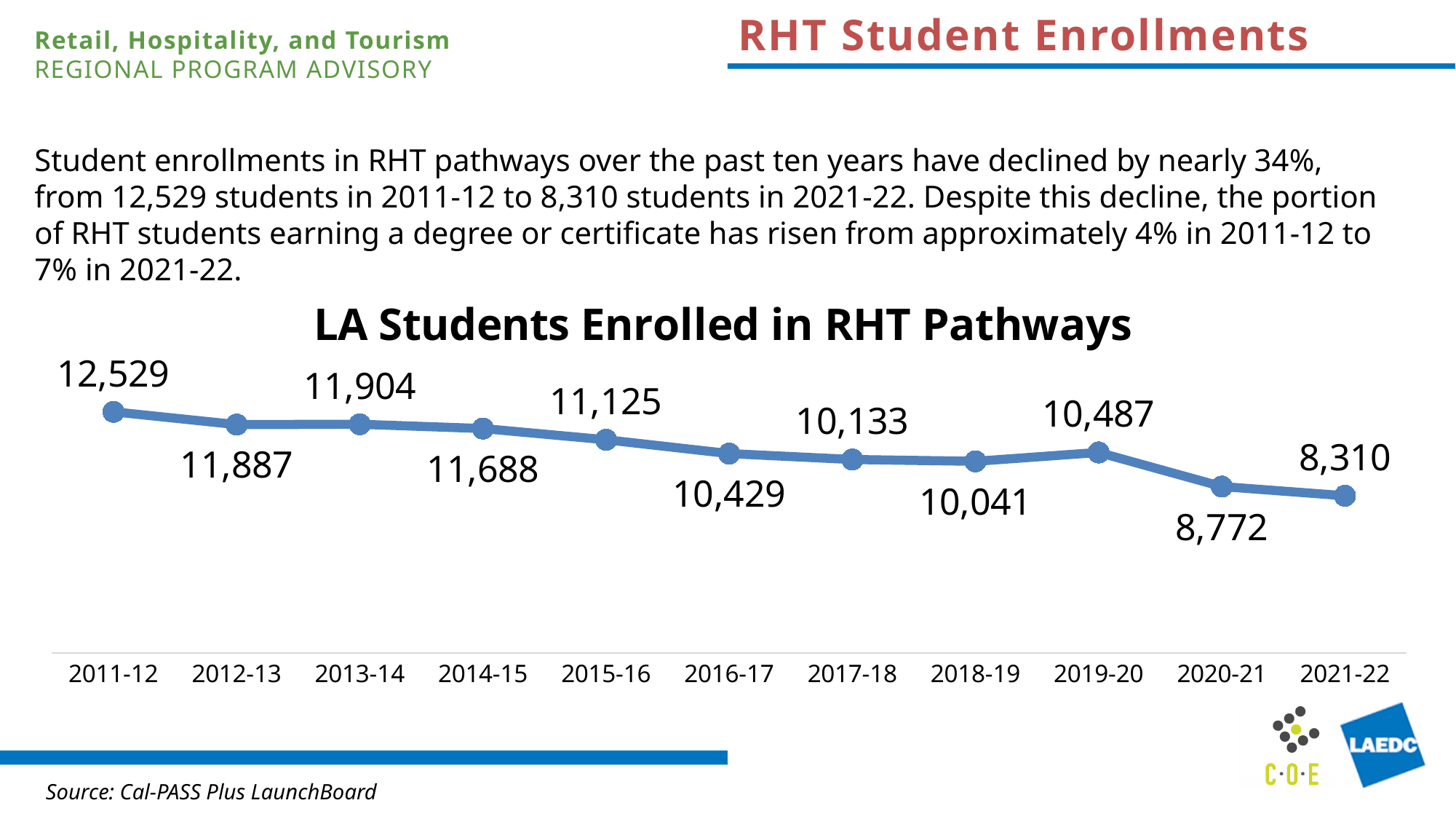
What is the difference in enrollment between 2019-20 and 2020-21? 1,715 Which year has higher enrollment, 2018-19 or 2019-20? 2019-20 What is the number of LA students enrolled in RHT pathways in 2011-12? 12,529 What is the enrollment value shown for 2016-17? 10,429 What is the enrollment value shown for 2019-20? 10,487 What is the difference in enrollment between 2011-12 and 2021-22? 4,219 How many academic years are plotted in the chart? 11 Which year has higher enrollment, 2013-14 or 2014-15? 2013-14 What is the title of the chart? LA Students Enrolled in RHT Pathways What type of chart is shown on the slide? Line chart Which year has the highest enrollment in the chart? 2011-12 Which year has the lowest enrollment in the chart? 2021-22